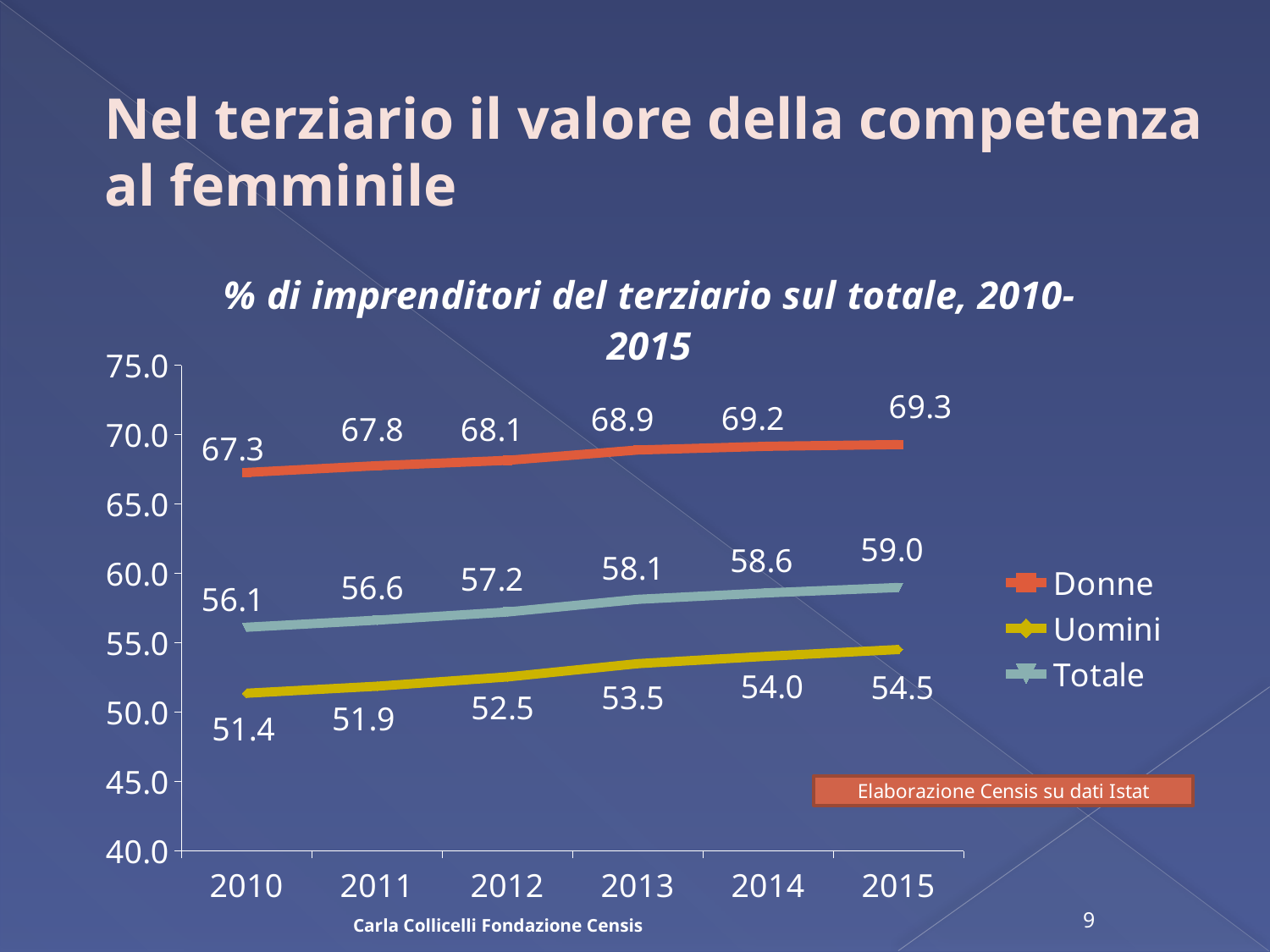
What is the value for Donne in 2010? 67.3 What kind of chart is shown on the slide? line chart How many series does the legend list? 3 What is the difference between the Donne and Uomini values in 2015? 14.8 Which is larger in 2012, the Totale value or the Uomini value? Totale In which year is the Uomini series lowest? 2010 Is the value for Donne in 2013 greater or less than 65.0? greater In which year is the Donne series highest? 2015 What is the value for Uomini in 2015? 54.5 What is the value for Totale in 2013? 58.1 Does the Totale series rise or fall from 2010 to 2015? rise How many years are shown on the x axis? 6